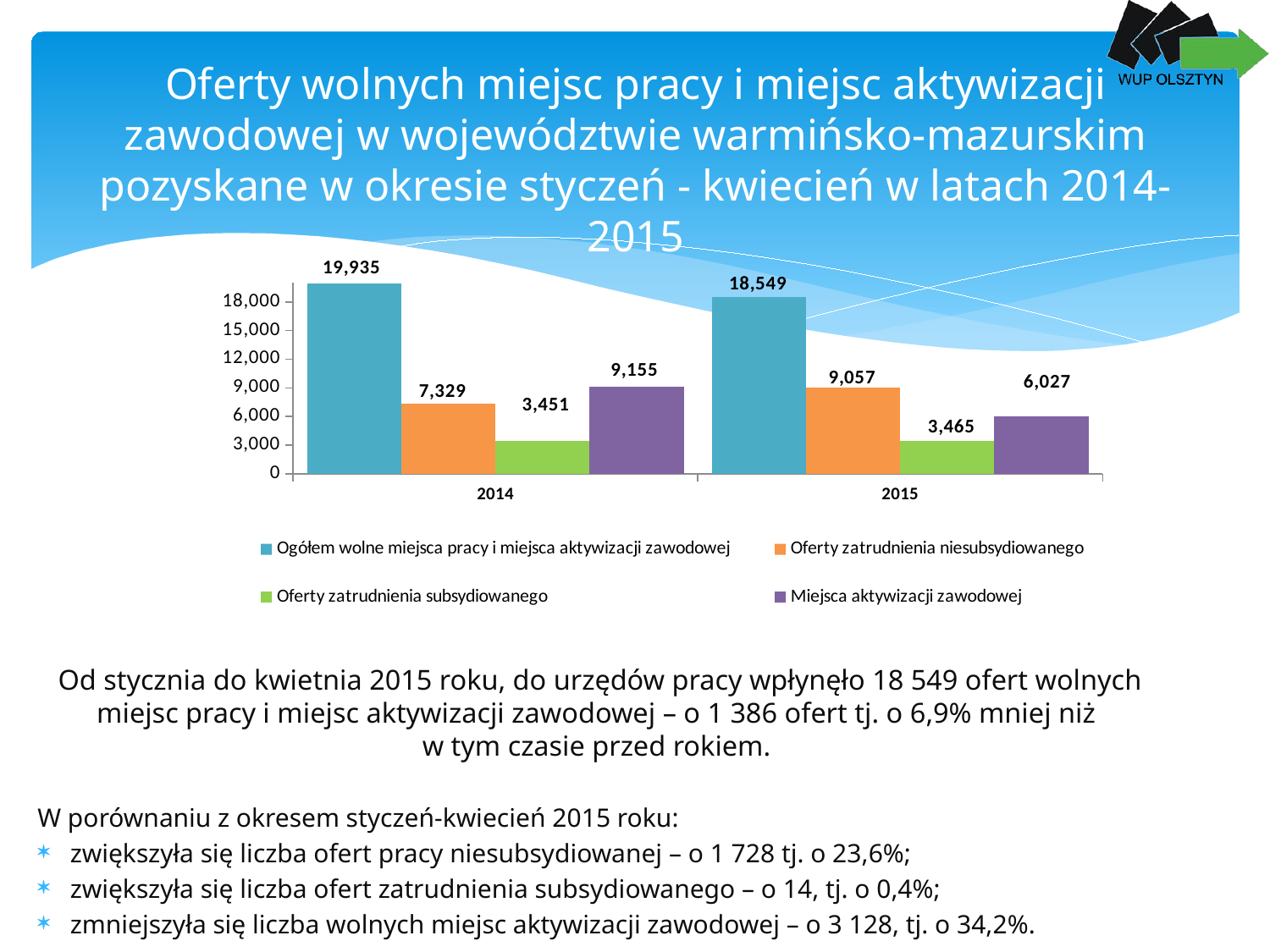
What is the value of 'Oferty zatrudnienia niesubsydiowanego' for 2015? 9,057 What colour are the bars for 'Oferty zatrudnienia niesubsydiowanego'? orange What is the value of 'Oferty zatrudnienia subsydiowanego' for 2015? 3,465 What type of chart is shown on the slide? bar chart What is the difference between the 'Ogółem wolne miejsca pracy i miejsca aktywizacji zawodowej' values for 2014 and 2015? 1,386 What is the value of 'Miejsca aktywizacji zawodowej' for 2014? 9,155 Which series has the lowest value in 2015? Oferty zatrudnienia subsydiowanego How many series does the legend list? 4 How many year categories are shown on the x axis? 2 What is the value of 'Ogółem wolne miejsca pracy i miejsca aktywizacji zawodowej' for 2014? 19,935 Which is larger: 'Miejsca aktywizacji zawodowej' in 2014 or in 2015? 2014 Does the value of 'Ogółem wolne miejsca pracy i miejsca aktywizacji zawodowej' rise or fall from 2014 to 2015? fall